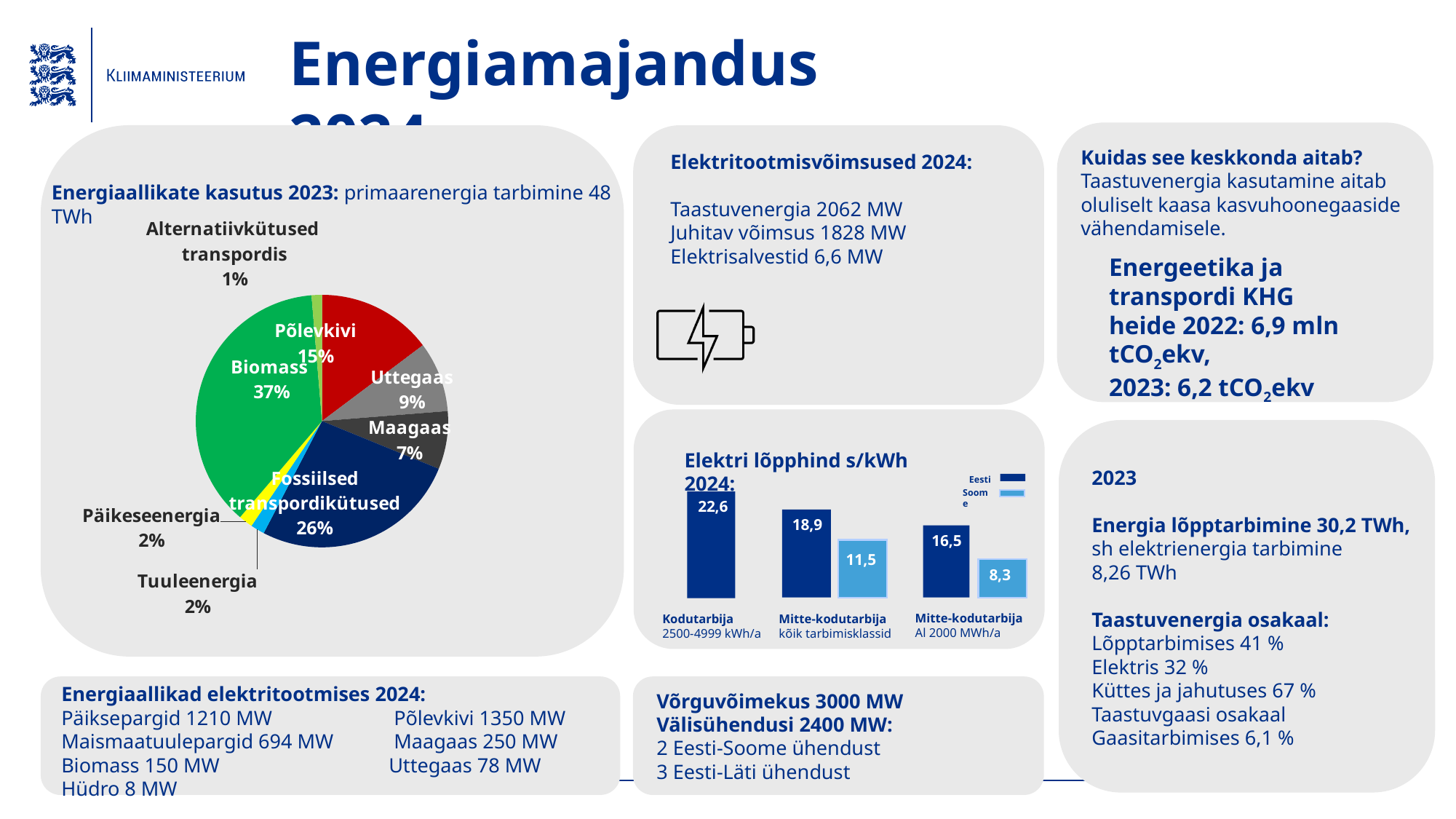
How many categories does the pie chart 'Energiaallikate kasutus 2023' show? 8 In the pie chart 'Energiaallikate kasutus 2023', which is larger: Uttegaas or Maagaas? Uttegaas What kind of chart is 'Elektri lõpphind s/kWh 2024'? bar chart In the bar chart 'Elektri lõpphind s/kWh 2024', what is the Soome value for Mitte-kodutarbija Al 2000 MWh/a? 8,3 In the pie chart 'Energiaallikate kasutus 2023', which category has the largest share? Biomass In the pie chart 'Energiaallikate kasutus 2023', which category has the smallest share? Alternatiivkütused transpordis In the pie chart 'Energiaallikate kasutus 2023', what is the difference in percentage points between Fossiilsed transpordikütused and Uttegaas? 17 In the pie chart 'Energiaallikate kasutus 2023', what share does Biomass have? 37% In the bar chart 'Elektri lõpphind s/kWh 2024', what is the difference between the Eesti and Soome values for Mitte-kodutarbija kõik tarbimisklassid? 7,4 How many series does the legend of the bar chart 'Elektri lõpphind s/kWh 2024' list? 2 In the pie chart 'Energiaallikate kasutus 2023', what share does Põlevkivi have? 15% In the bar chart 'Elektri lõpphind s/kWh 2024', what is the Eesti value for Kodutarbija? 22,6